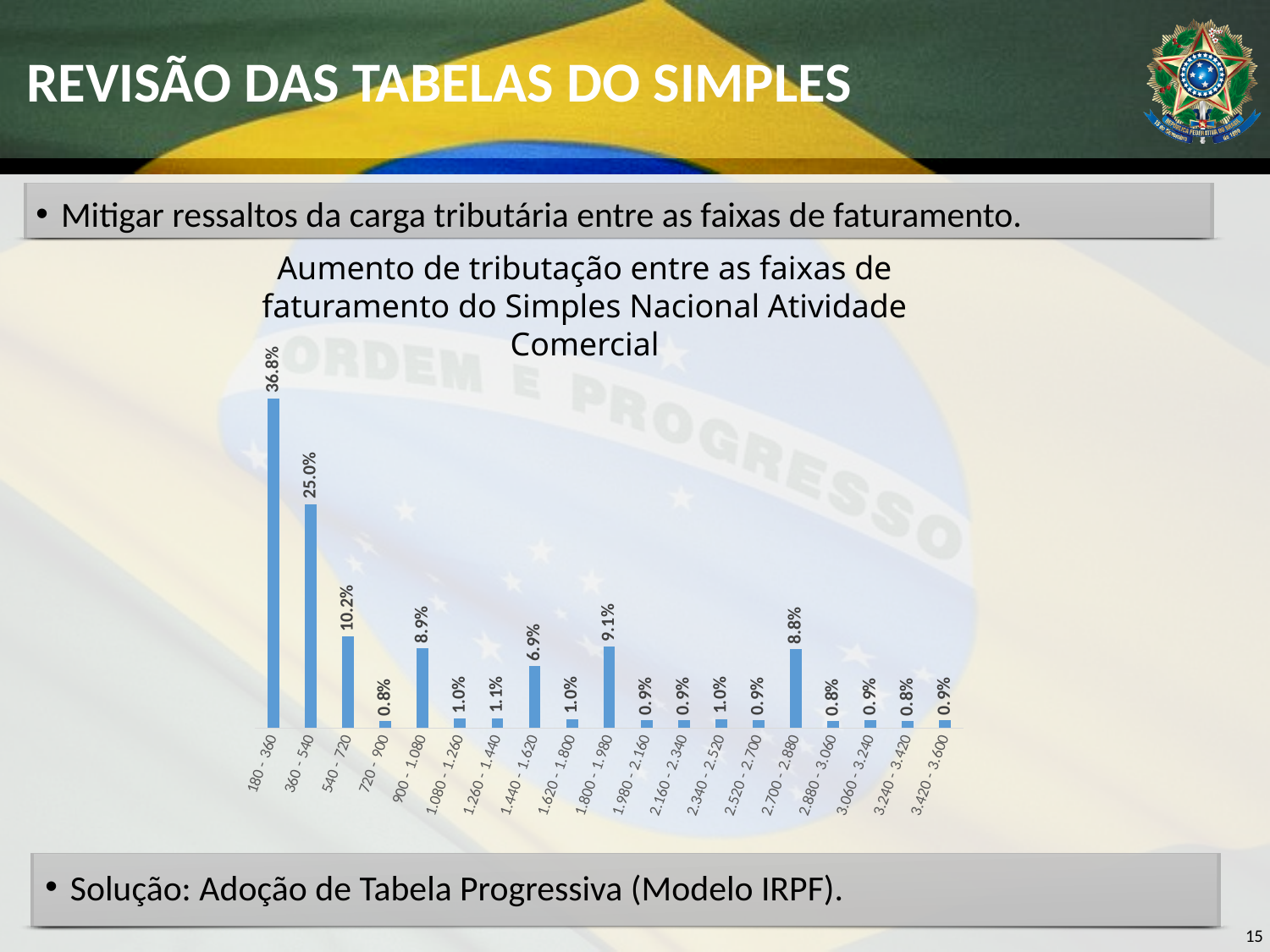
Which is larger, the value for 1.800 - 1.980 or the value for 2.700 - 2.880? 1.800 - 1.980 What is the value for the 360 - 540 range? 25.0% Which is larger, the value for 540 - 720 or the value for 1.440 - 1.620? 540 - 720 What is the value for the 180 - 360 range? 36.8% How many revenue ranges are shown on the x axis? 19 What is the difference between the values for 180 - 360 and 360 - 540? 11.8% What is the difference between the values for 540 - 720 and 900 - 1.080? 1.3% What kind of chart is shown on the slide? Bar chart Which revenue range has the highest value? 180 - 360 What is the title of the chart? Aumento de tributação entre as faixas de faturamento do Simples Nacional Atividade Comercial What is the value for the 1.440 - 1.620 range? 6.9% What is the value for the 2.700 - 2.880 range? 8.8%